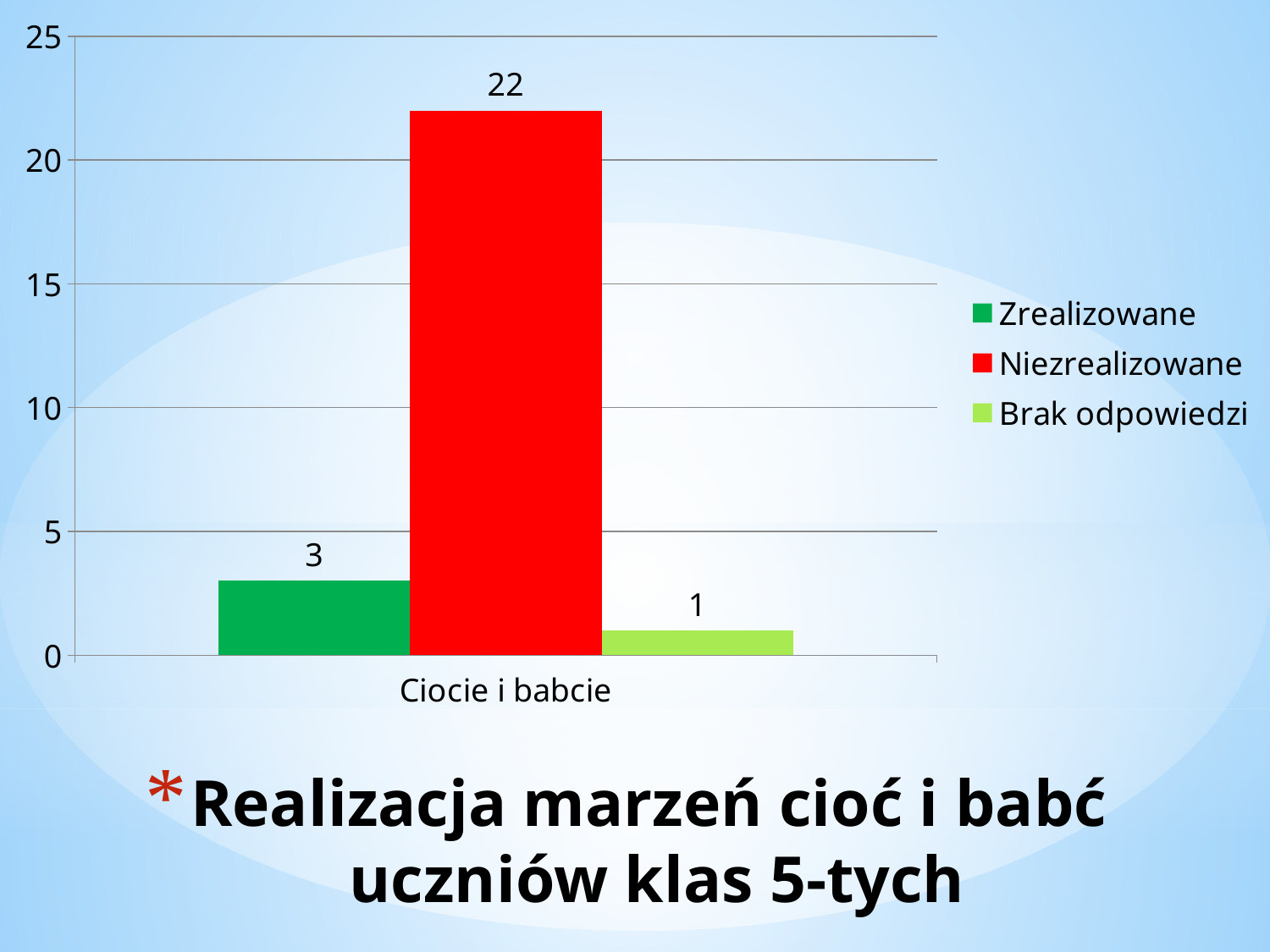
How many series does the legend list? 3 What kind of chart is shown? bar chart Which series has the highest value? Niezrealizowane What is the value for Brak odpowiedzi? 1 What is the value for Zrealizowane? 3 Which series has the lowest value? Brak odpowiedzi What is the value for Niezrealizowane? 22 What is the difference between Niezrealizowane and Zrealizowane? 19 Is the value for Niezrealizowane greater or less than 20? greater What is the category label on the x axis? Ciocie i babcie Which is larger, Zrealizowane or Brak odpowiedzi? Zrealizowane What colour is the bar for Niezrealizowane? red